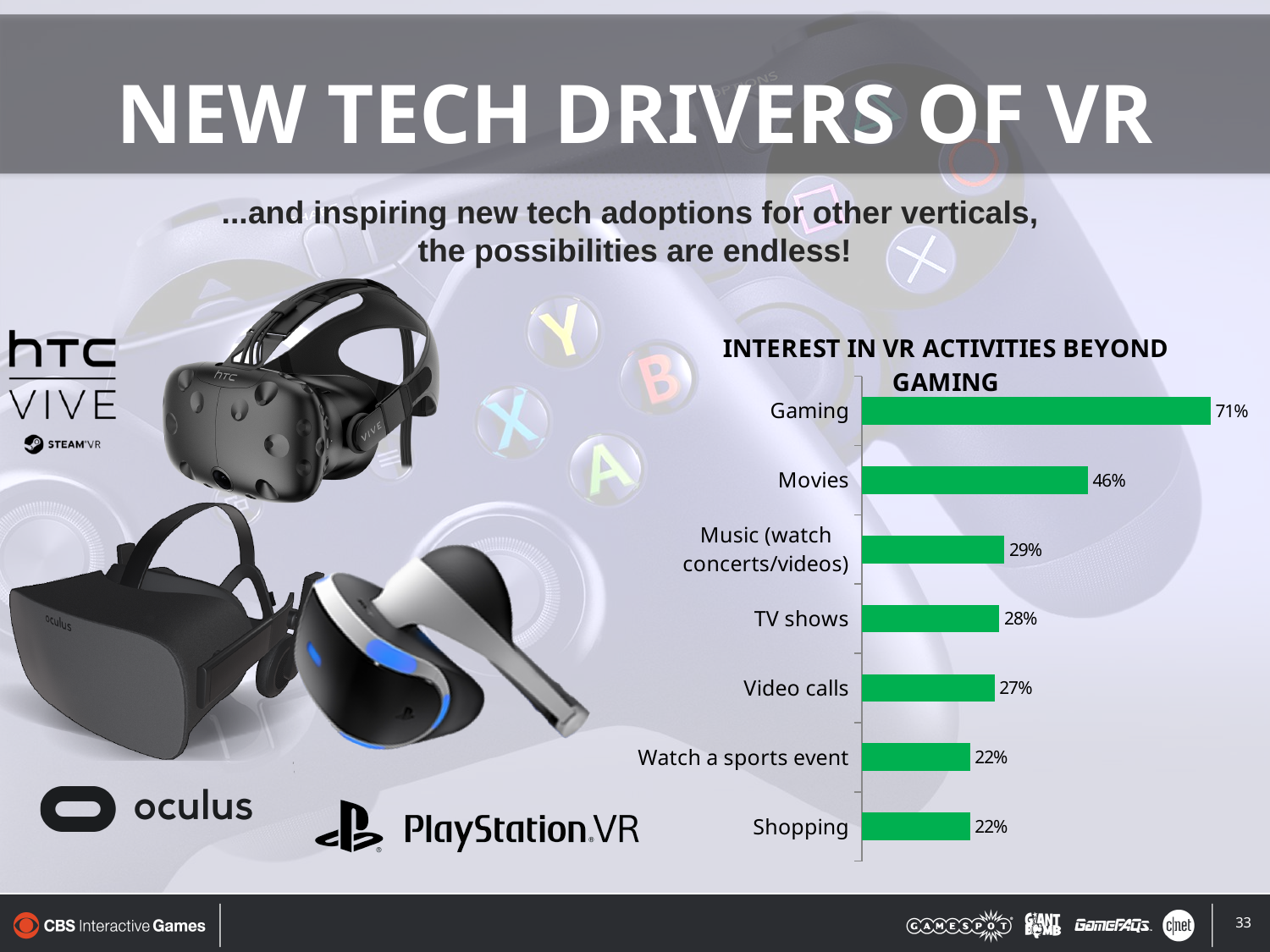
How many activities are shown in the chart? 7 What is the title of the chart? INTEREST IN VR ACTIVITIES BEYOND GAMING What colour are the bars in the chart? Green What kind of chart is shown on the slide? Bar chart Which activity has the highest interest? Gaming What is the value for Video calls? 27% Which is larger, the value for Movies or the value for TV shows? Movies What is the value for Movies? 46% What percentage of respondents are interested in Gaming in VR? 71% What is the difference between the values for Gaming and Movies? 25% What is the difference between the values for Movies and TV shows? 18% What is the value for Music (watch concerts/videos)? 29%